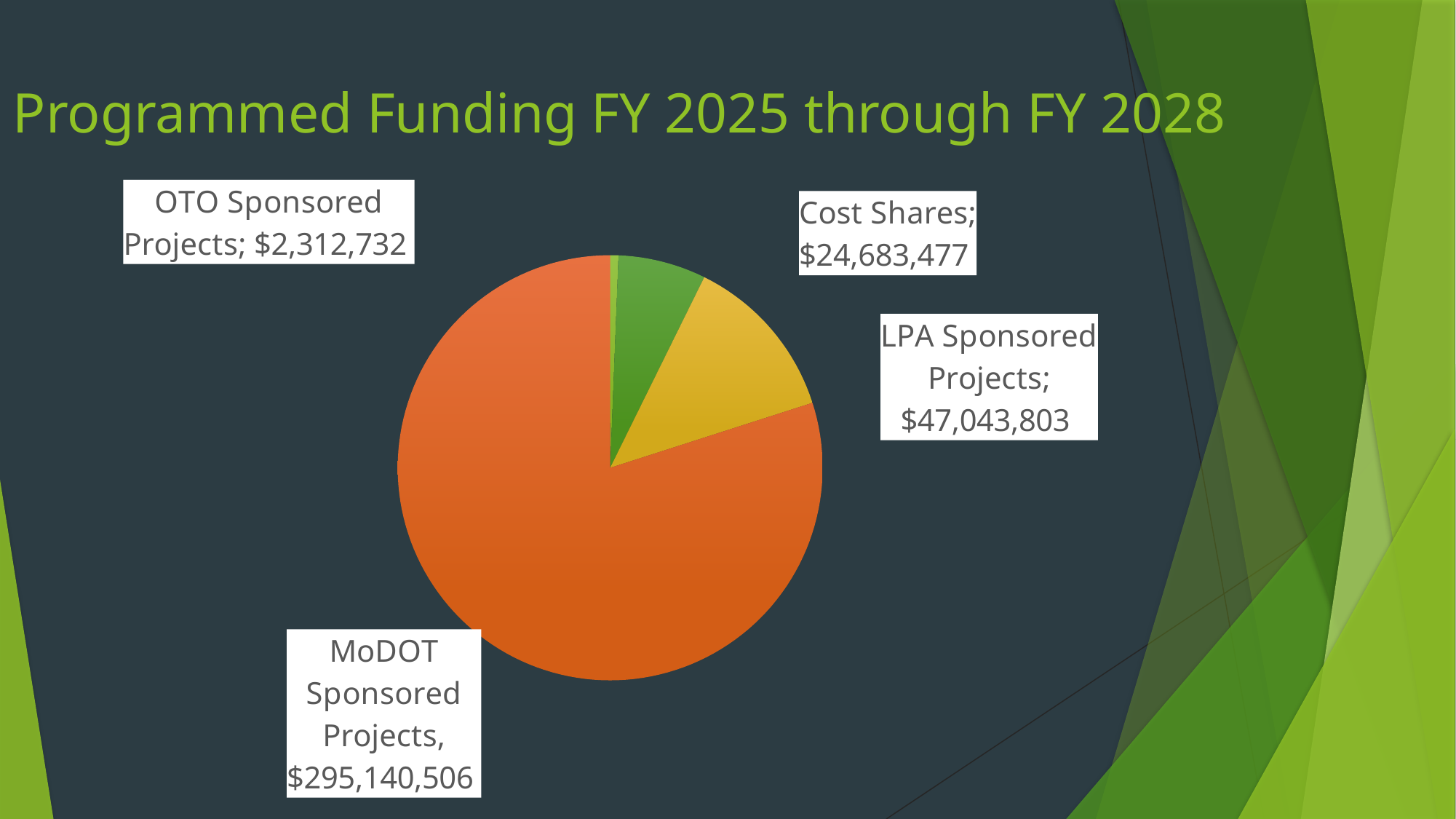
What is the total programmed funding across all four categories? $369,180,518 What is the difference between the funding for LPA Sponsored Projects and Cost Shares? $22,360,326 Which category has the largest share of programmed funding? MoDOT Sponsored Projects What is the programmed funding amount for LPA Sponsored Projects? $47,043,803 What is the title of the chart on the slide? Programmed Funding FY 2025 through FY 2028 How many categories are shown in the pie chart? 4 What is the programmed funding amount for OTO Sponsored Projects? $2,312,732 What type of chart is shown on the slide? Pie chart What is the programmed funding amount for Cost Shares? $24,683,477 What is the programmed funding amount for MoDOT Sponsored Projects? $295,140,506 Which is larger, the funding for LPA Sponsored Projects or for Cost Shares? LPA Sponsored Projects Which category has the smallest share of programmed funding? OTO Sponsored Projects